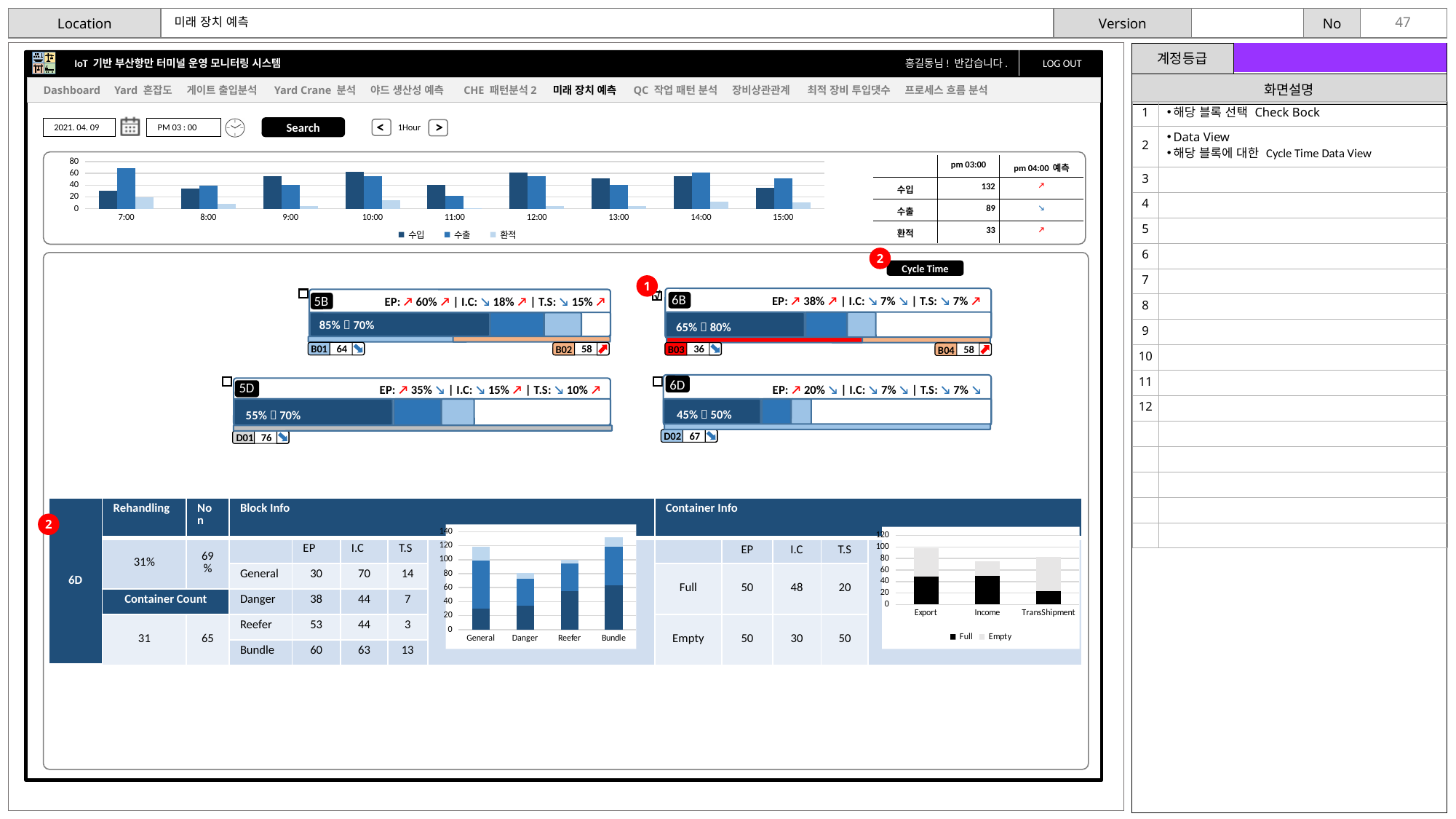
In the top hourly chart, is the value for 수출 at 7:00 greater or less than 60? greater How many time categories are shown on the x axis of the top hourly chart? 9 In the Block Info chart, which category has the shortest stacked bar? Danger In the top hourly chart, is the value for 수출 at 11:00 greater or less than 40? less In the Container Info chart, which category has the smallest Full segment? TransShipment In the top hourly chart, is the value for 수입 at 7:00 greater or less than 40? less What type of chart is the hourly chart at the top of the slide? bar chart How many series does the legend of the top hourly chart list? 3 In the Block Info chart, which category has the tallest stacked bar? Bundle In the top hourly chart, which series is shown in the lightest colour? 환적 How many series does the legend of the Container Info chart list? 2